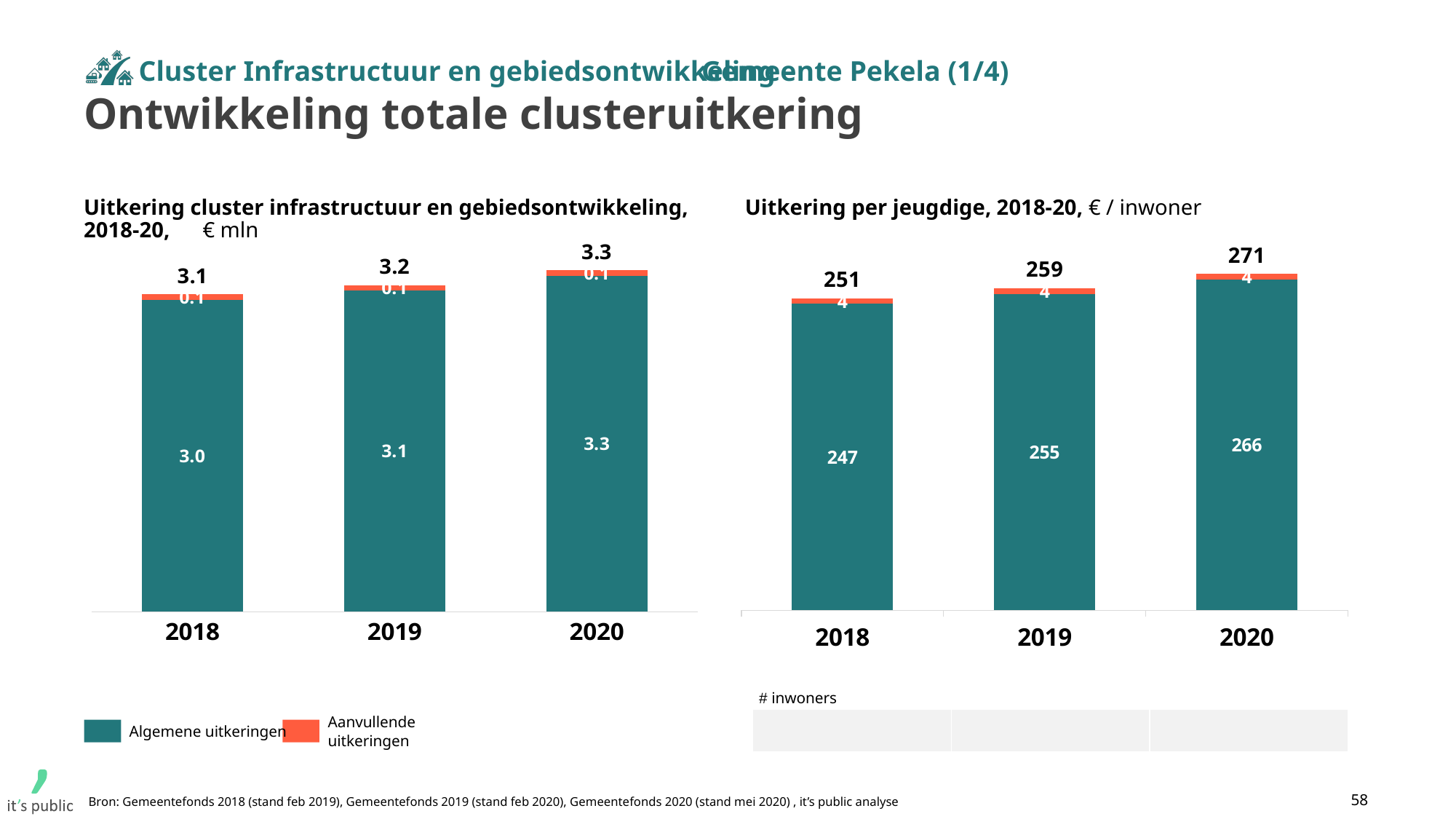
In the left chart (Uitkering cluster infrastructuur en gebiedsontwikkeling), which year has the highest total uitkering? 2020 In the right chart (Uitkering per jeugdige), do the total values rise or fall from 2018 to 2020? rise In the right chart (Uitkering per jeugdige), what is the difference in Algemene uitkeringen between 2020 and 2018? 19 In the left chart (Uitkering cluster infrastructuur en gebiedsontwikkeling), what is the value of Aanvullende uitkeringen for 2019? 0.1 In the right chart (Uitkering per jeugdige), what is the value of Algemene uitkeringen for 2019? 255 In the left chart (Uitkering cluster infrastructuur en gebiedsontwikkeling), what is the total of the stacked bar for 2020? 3.3 In the right chart (Uitkering per jeugdige), which year has the lowest total uitkering per inwoner? 2018 What kind of chart is the right chart (Uitkering per jeugdige)? stacked bar chart How many series does the legend list for the left chart? 2 In the left chart (Uitkering cluster infrastructuur en gebiedsontwikkeling), what is the value of Algemene uitkeringen for 2018? 3.0 In the left chart (Uitkering cluster infrastructuur en gebiedsontwikkeling), what is the difference in Algemene uitkeringen between 2020 and 2018? 0.3 In the right chart (Uitkering per jeugdige), what is the total of the stacked bar for 2018? 251